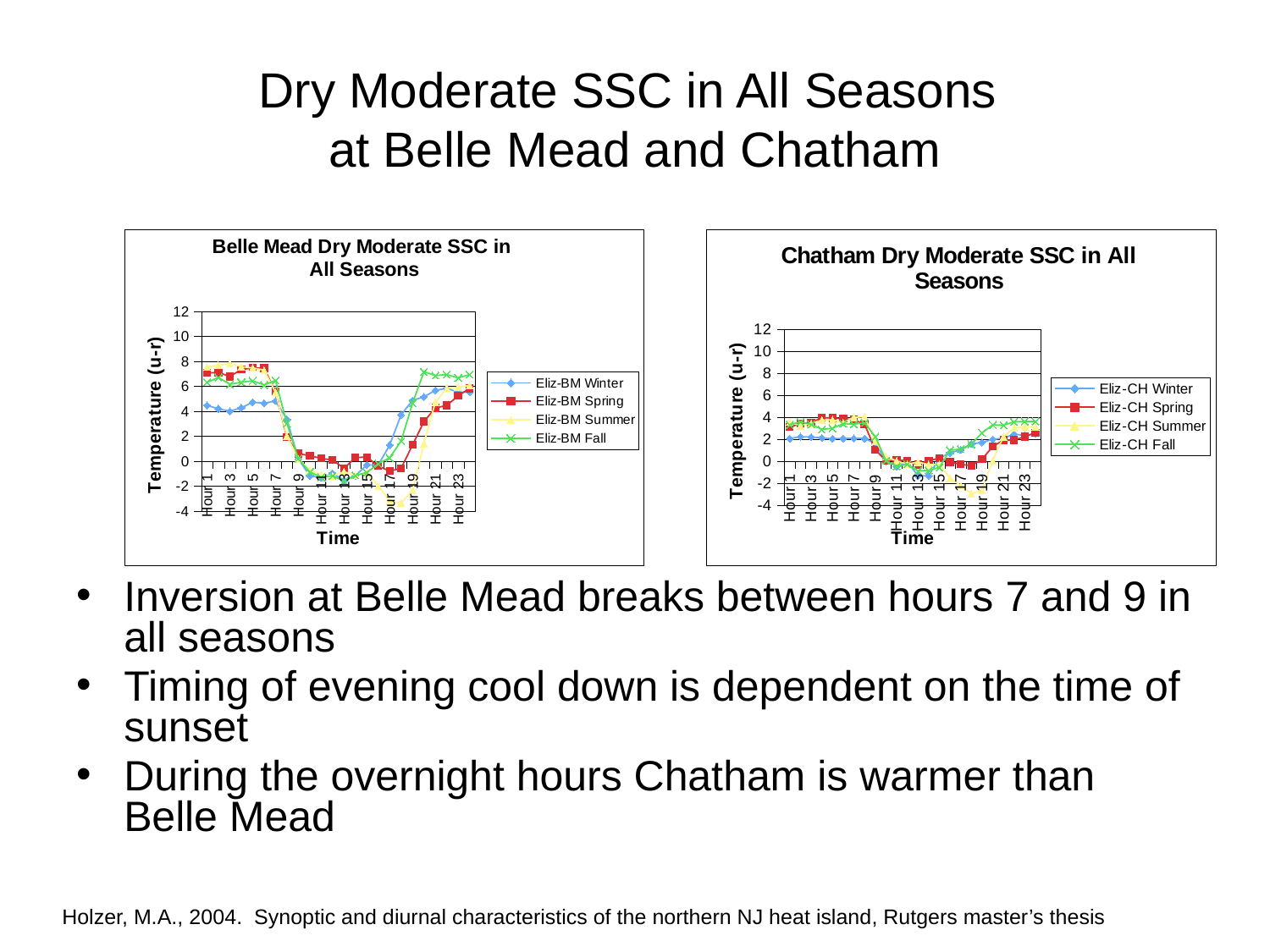
What is the y-axis label on the Chatham Dry Moderate SSC in All Seasons chart? Temperature (u-r) In the Chatham Dry Moderate SSC in All Seasons chart, is the value for Eliz-CH Fall at Hour 23 greater or less than 2? greater In the Belle Mead Dry Moderate SSC in All Seasons chart, is the value for Eliz-BM Spring at Hour 3 greater or less than 6? greater In the Belle Mead Dry Moderate SSC in All Seasons chart, is the value for Eliz-BM Winter at Hour 1 greater or less than 2? greater What type of chart is the Belle Mead Dry Moderate SSC in All Seasons chart? line chart What are the four legend entries on the Belle Mead Dry Moderate SSC in All Seasons chart? Eliz-BM Winter, Eliz-BM Spring, Eliz-BM Summer, Eliz-BM Fall How many series does the legend of the Belle Mead Dry Moderate SSC in All Seasons chart list? 4 In the Belle Mead Dry Moderate SSC in All Seasons chart, does the Eliz-BM Spring series rise or fall between Hour 7 and Hour 11? fall In the Chatham Dry Moderate SSC in All Seasons chart, does the Eliz-CH Fall series rise or fall between Hour 15 and Hour 23? rise How many series does the legend of the Chatham Dry Moderate SSC in All Seasons chart list? 4